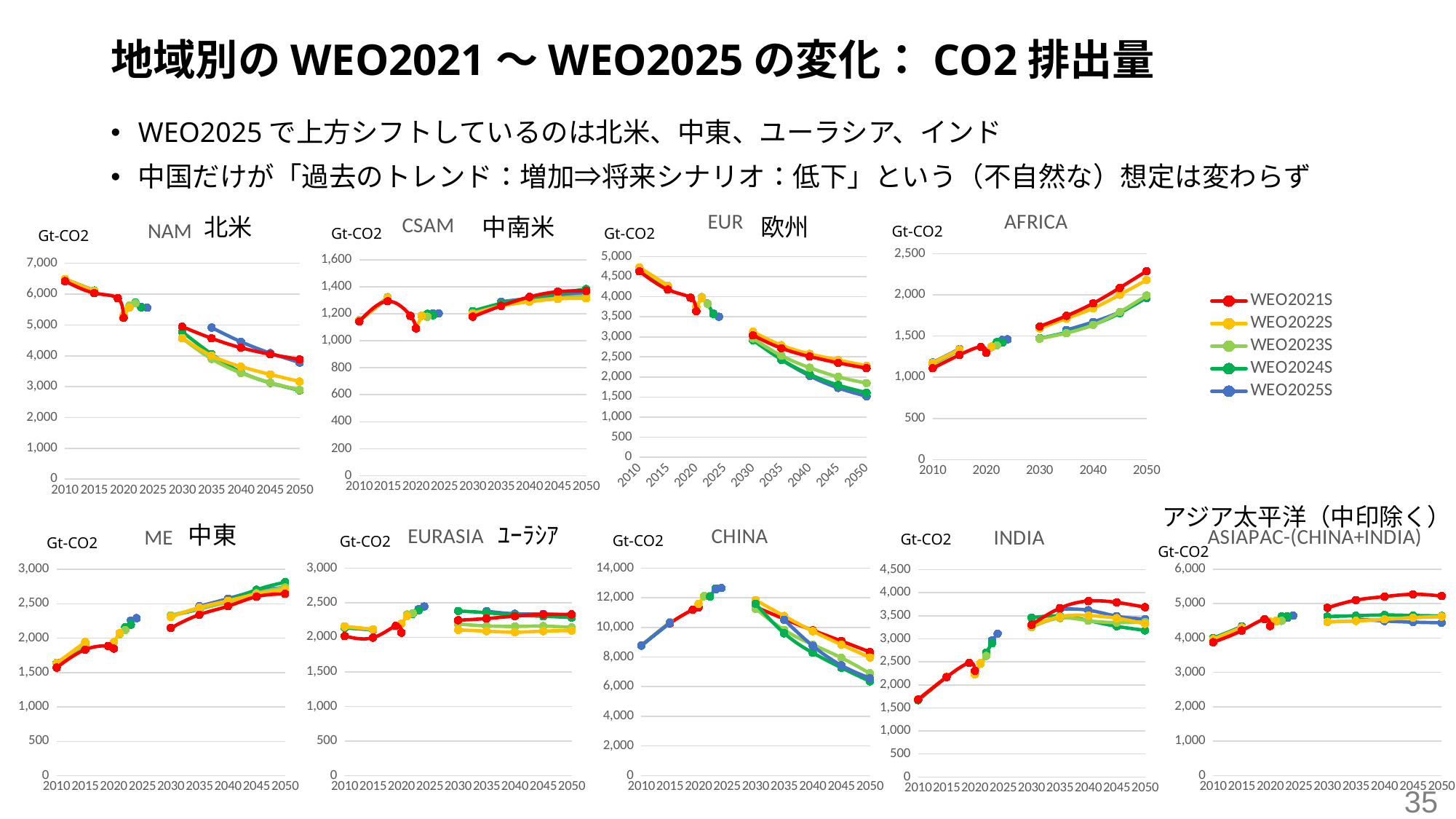
In the EUR (欧州) chart, which series has the highest value in 2050? WEO2022S In the CHINA chart, which series is larger in 2050, WEO2021S or WEO2024S? WEO2021S In the NAM (北米) chart, which series is larger in 2050, WEO2021S or WEO2023S? WEO2021S How many series does the legend list? 5 In the INDIA chart, is the WEO2021S value in 2010 greater or less than 2,000? less In the CHINA chart, does the WEO2021S line rise or fall from 2030 to 2050? fall In the AFRICA chart, does the WEO2021S line rise or fall from 2030 to 2050? rise What unit label is shown above the y axis of each chart? Gt-CO2 What kind of chart is the NAM (北米) chart? line chart In the NAM (北米) chart, is the WEO2021S value in 2010 greater or less than 6,000? greater